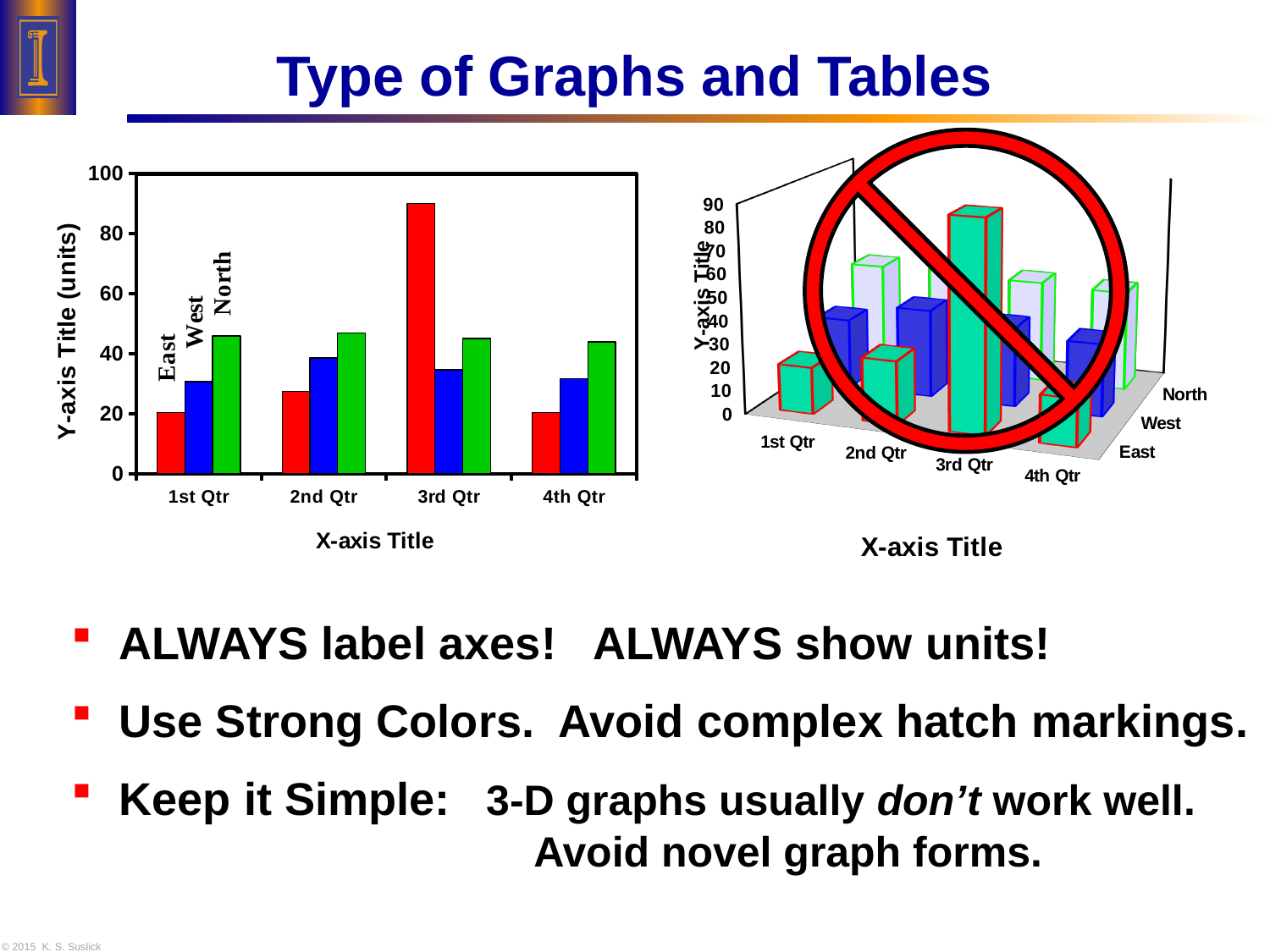
In the chart on the left, how many quarters are shown on the x axis? 4 In the chart on the left, is the East value for 1st Qtr greater or less than 40? less In the chart on the left, how many data series (East, West, North) are plotted? 3 What kind of chart is the chart on the left of the slide? bar chart In the chart on the left, for 3rd Qtr, which is larger: the East bar or the West bar? East In the chart on the left, is the East value for 3rd Qtr greater or less than 80? greater In the chart on the left, for 1st Qtr, which is larger: the East bar or the North bar? North What is the y-axis title of the chart on the left? Y-axis Title (units) What kind of chart is the crossed-out chart on the right of the slide? bar chart In the chart on the left, which series has the lowest bar in 1st Qtr? East In the chart on the left, which quarter has the highest East (red) bar? 3rd Qtr In the chart on the right, which quarter has the tallest bar? 3rd Qtr